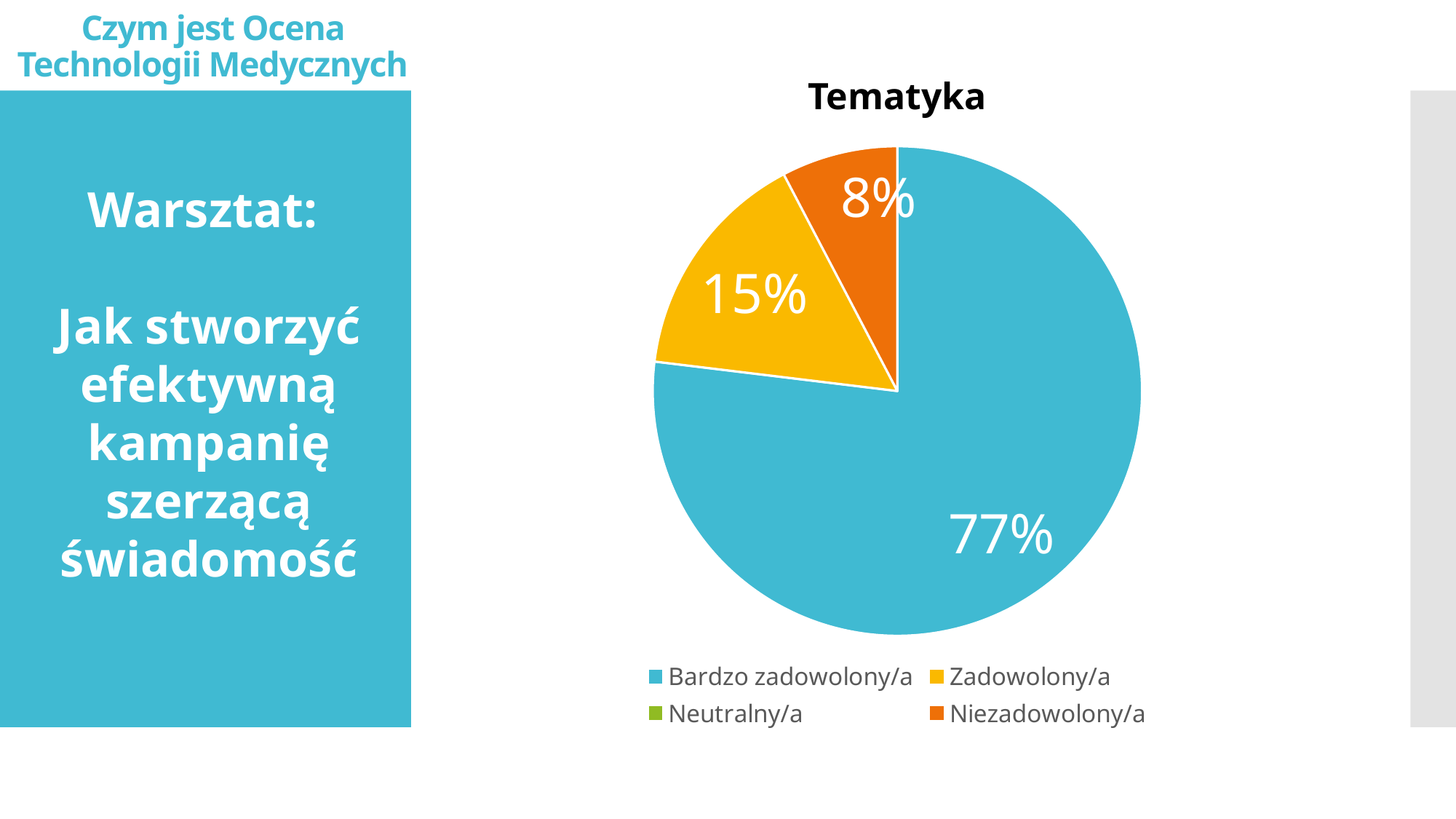
How many entries does the legend list? 4 What share of the pie does Bardzo zadowolony/a have? 77% What is the difference between the Bardzo zadowolony/a and Zadowolony/a shares? 62% What share of the pie does Niezadowolony/a have? 8% What kind of chart is shown on the slide? pie chart What colour is the Zadowolony/a slice? yellow What is the difference between the Zadowolony/a and Niezadowolony/a shares? 7% Which category has the largest slice of the pie? Bardzo zadowolony/a Which of the visible slices is the smallest? Niezadowolony/a What is the title of the chart? Tematyka What share of the pie does Zadowolony/a have? 15% Which is larger, the Zadowolony/a slice or the Niezadowolony/a slice? Zadowolony/a